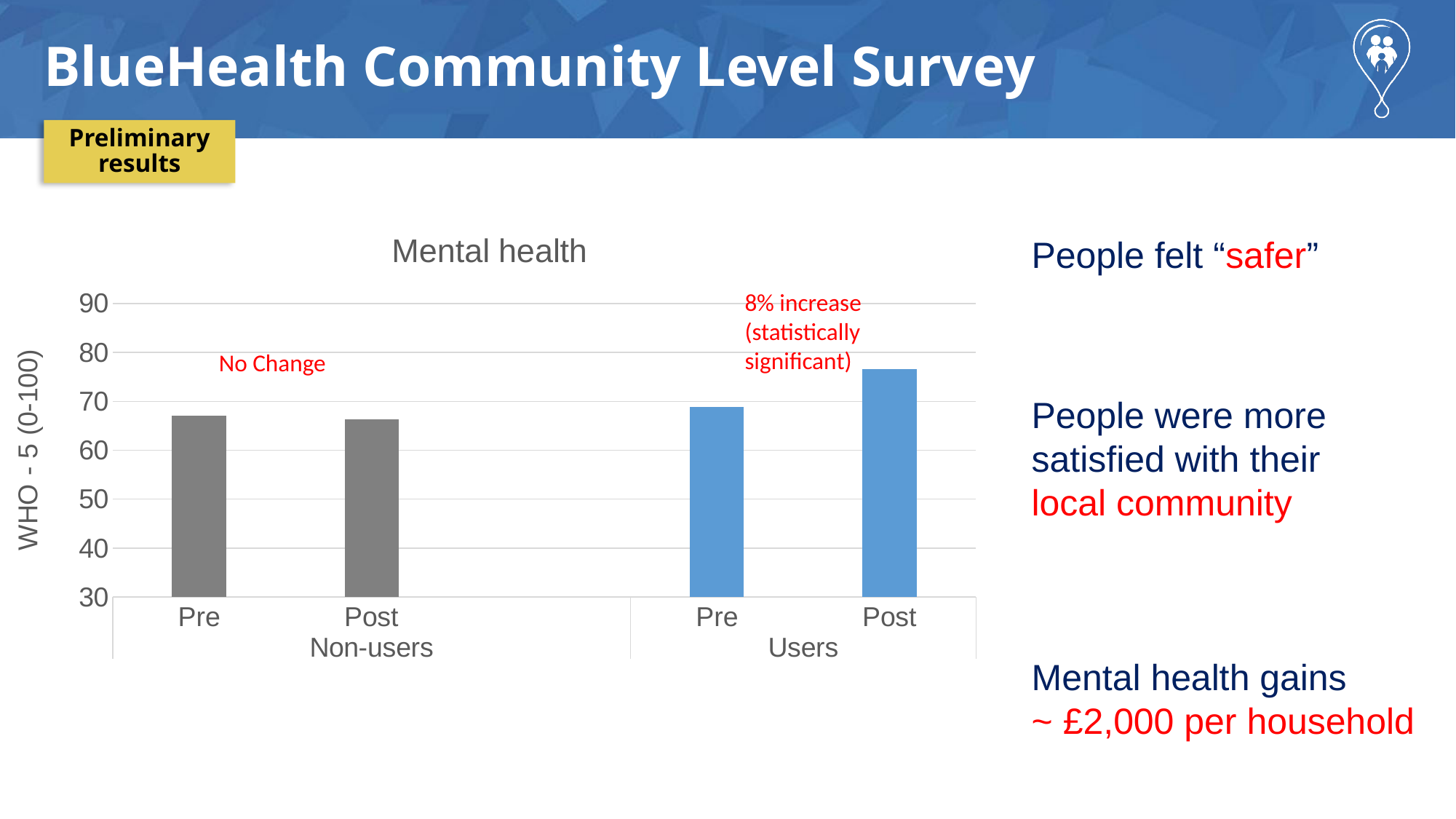
Is the value for Non-users Post greater or less than 60? greater What is the title of the chart? Mental health Which bar in the chart is the highest? Users Post What is the label on the vertical axis of the chart? WHO - 5 (0-100) Is the value for Users Post greater or less than 80? less Which is larger, the Users Pre bar or the Users Post bar? Users Post Is the value for Users Post greater or less than 70? greater What percentage increase is annotated above the Users bars? 8% increase For the Users group, do the values rise or fall from Pre to Post? rise How many bars are plotted in the chart? 4 What kind of chart is shown on the slide? bar chart